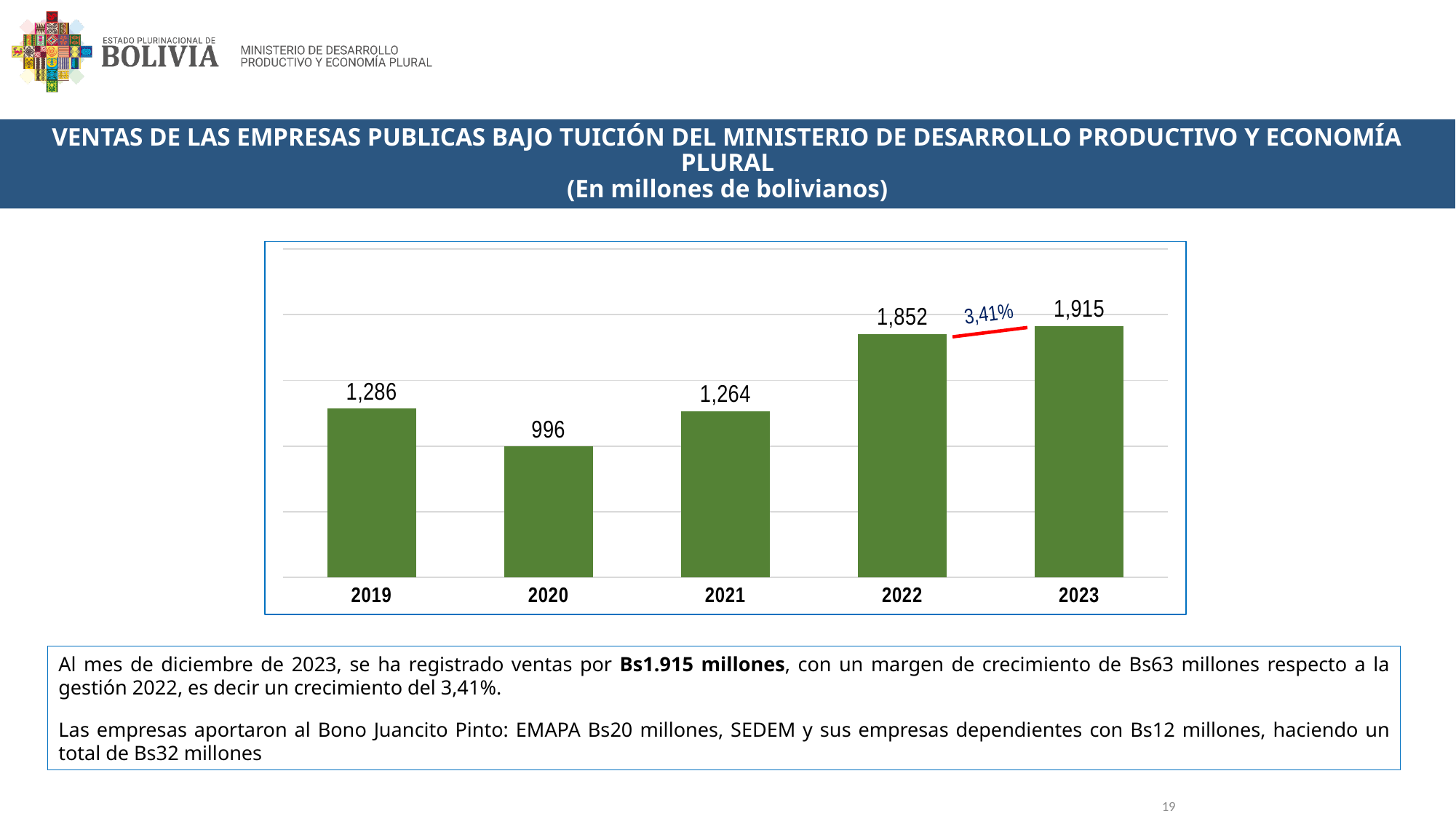
What is the sales value for 2020? 996 Do the sales values rise or fall from 2021 to 2023? Rise What is the sales value for 2023? 1,915 Which year has the highest sales value? 2023 How many years are shown on the chart? 5 What percentage growth is annotated between the 2022 and 2023 bars? 3,41% Which is larger, the sales value for 2019 or for 2021? 2019 What kind of chart is shown on the slide? Bar chart What is the difference between the sales values for 2019 and 2020? 290 What is the sales value for 2019? 1,286 What is the difference between the sales values for 2023 and 2022? 63 Which year has the lowest sales value? 2020